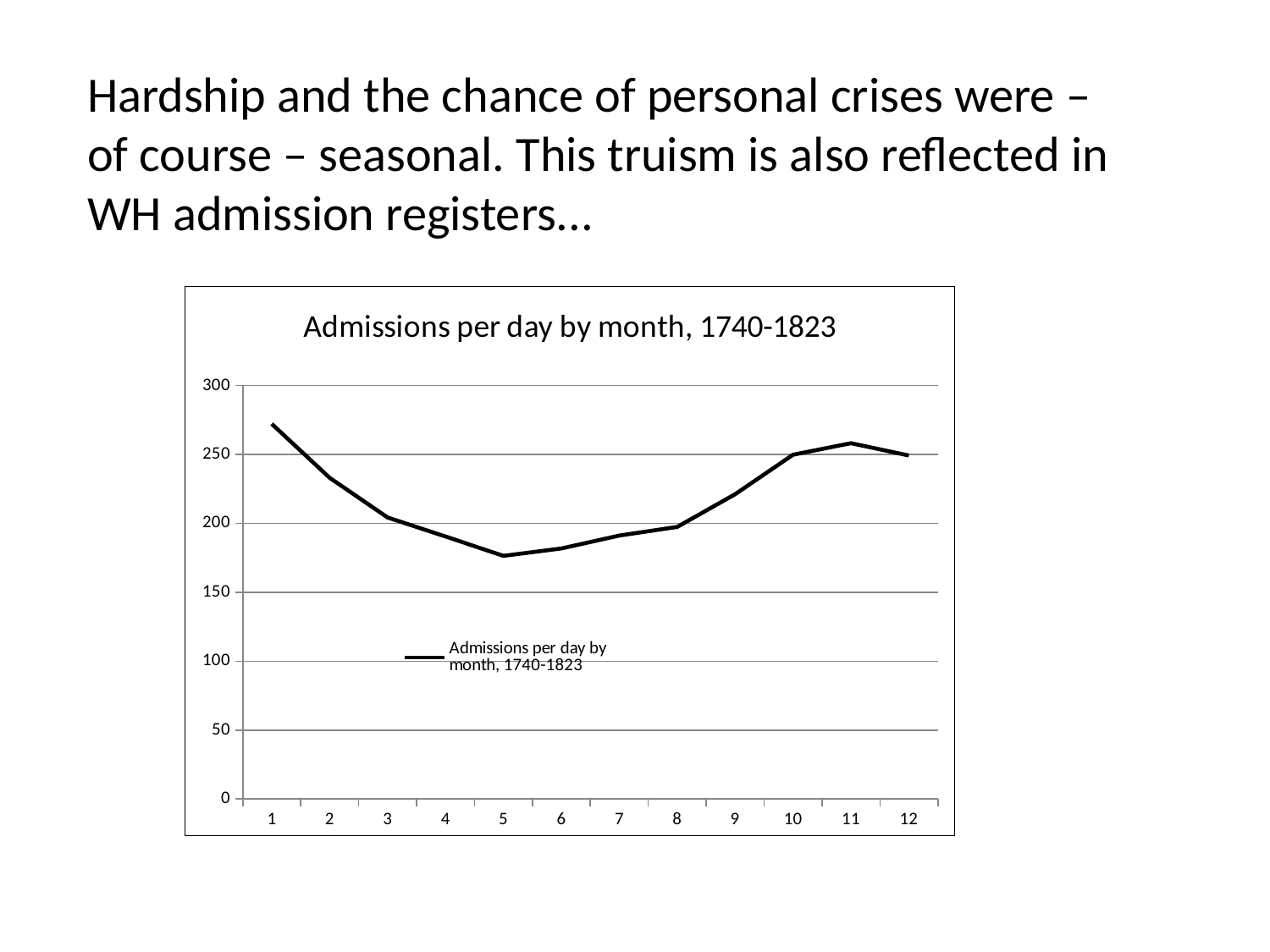
How many months are plotted along the x axis? 12 Which month has the highest admissions per day? 1 Is the value for month 1 greater or less than 250? greater Is the value for month 2 greater or less than 250? less What kind of chart is shown on the slide? line chart Which month has the lowest admissions per day? 5 How many series does the legend list? 1 What is the title of the chart? Admissions per day by month, 1740-1823 Is the value for month 5 greater or less than 200? less Which has the higher admissions per day, month 1 or month 11? month 1 Do admissions per day rise or fall from month 1 to month 5? fall